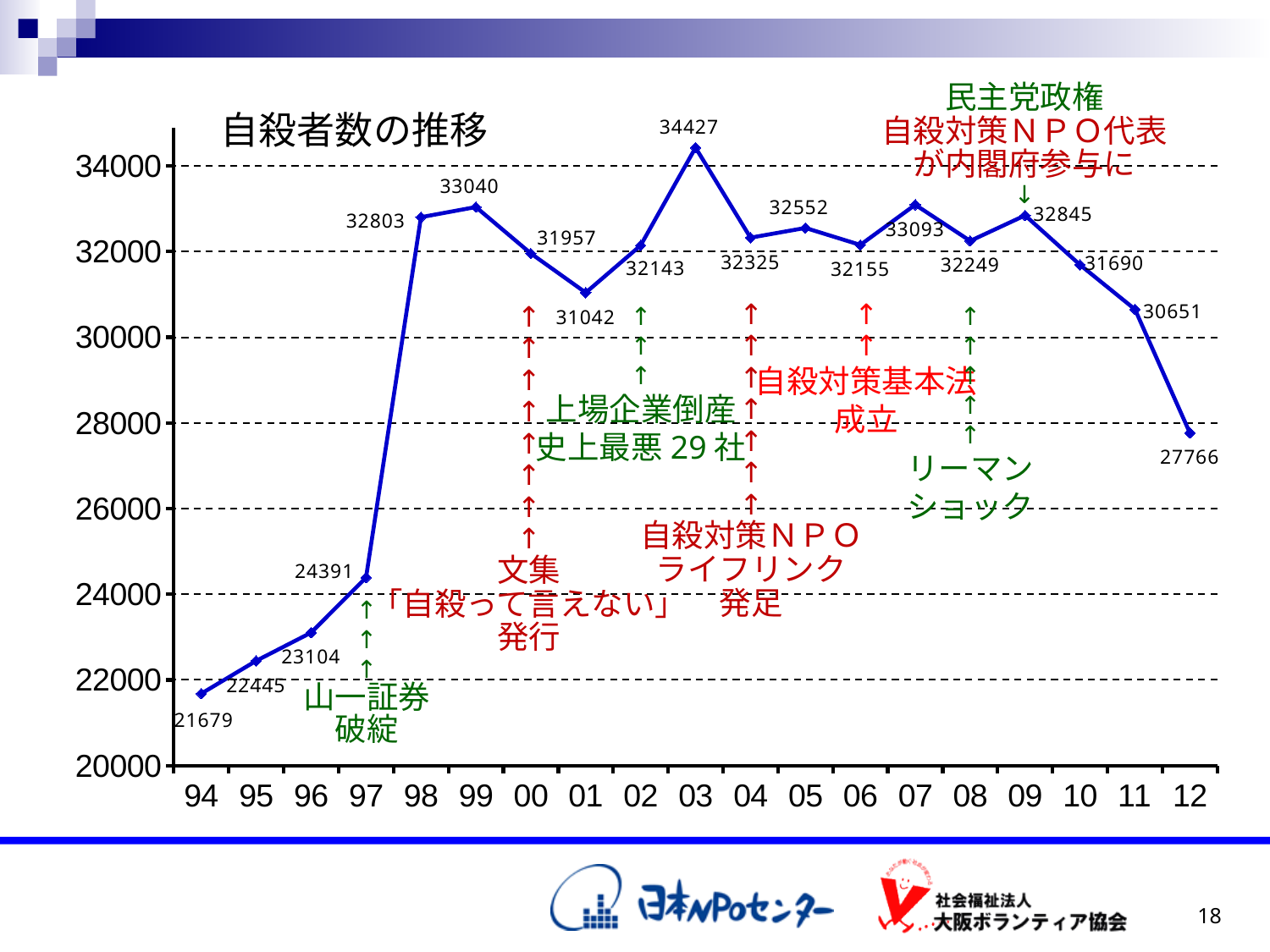
Which is larger, the value for 99 or the value for 07? 07 What is the value for 03 in the chart? 34427 What is the value for 94 in the chart? 21679 Do the values rise or fall from 09 to 12? fall Which year has the highest value in the chart? 03 What type of chart is shown on the slide? line chart How many data points are plotted in the chart? 19 What is the value for 12 in the chart? 27766 What is the value for 98 in the chart? 32803 What is the difference between the values for 98 and 97? 8412 Which year has the lowest value in the chart? 94 What is the title of the chart? 自殺者数の推移